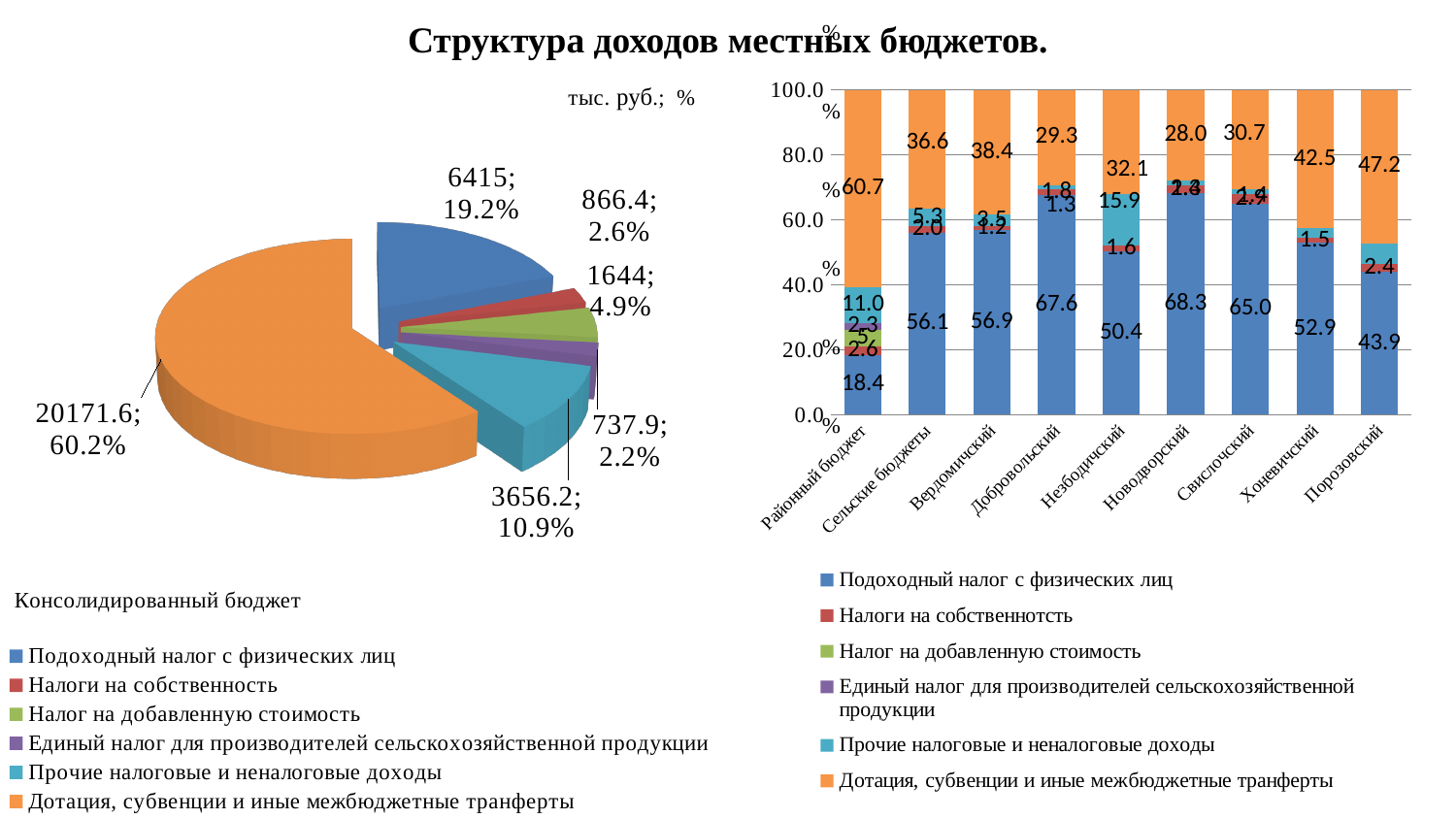
In the stacked bar chart on the right, which is larger: the 'Дотация' value for Хоневичский or for Свислочский? Хоневичский In the pie chart on the left, which category has the smallest slice? Единый налог для производителей сельскохозяйственной продукции In the pie chart on the left, what is the difference between the values for 'Налог на добавленную стоимость' and 'Налоги на собственность' (in тыс. руб.)? 777.6 In the stacked bar chart on the right, which category has the highest value for 'Подоходный налог с физических лиц'? Новодворский In the stacked bar chart on the right, what is the value of 'Подоходный налог с физических лиц' for Районный бюджет? 18.4 In the stacked bar chart on the right, what is the value of 'Дотация, субвенции и иные межбюджетные транферты' for Порозовский? 47.2 In the pie chart on the left, what share does 'Подоходный налог с физических лиц' have? 19.2% In the pie chart on the left, what value is shown for the slice 'Дотация, субвенции и иные межбюджетные транферты'? 20171.6; 60.2% In the stacked bar chart on the right, how many categories are shown on the x axis? 9 In the stacked bar chart on the right, how many series does the legend list? 6 What type of chart is shown on the right side of the slide? Stacked bar chart In the pie chart on the left, how many slices are there? 6